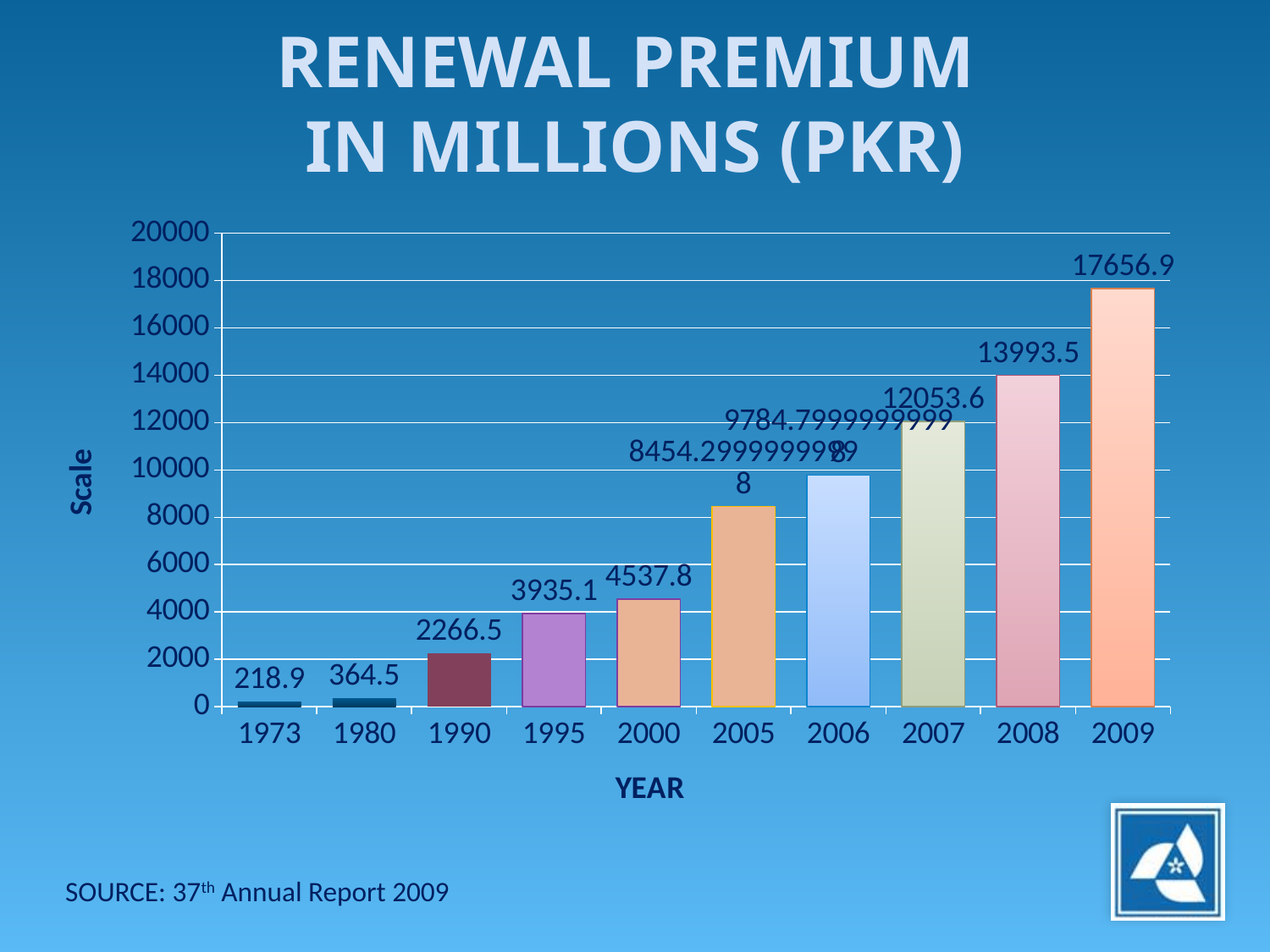
How many years are shown on the x axis? 10 What is the renewal premium value for 2009? 17656.9 What is the renewal premium value for 1990? 2266.5 Is the value for 2005 greater or less than 10000? less What is the difference between the renewal premium in 2000 and in 1995? 602.7 What is the difference between the renewal premium in 2009 and in 2008? 3663.4 Which year has the lowest renewal premium? 1973 Which year has the highest renewal premium? 2009 What is the renewal premium value for 2007? 12053.6 What is the renewal premium value for 1973? 218.9 Do the renewal premium values rise or fall from 1973 to 2009? Rise What type of chart is shown on the slide? Bar chart